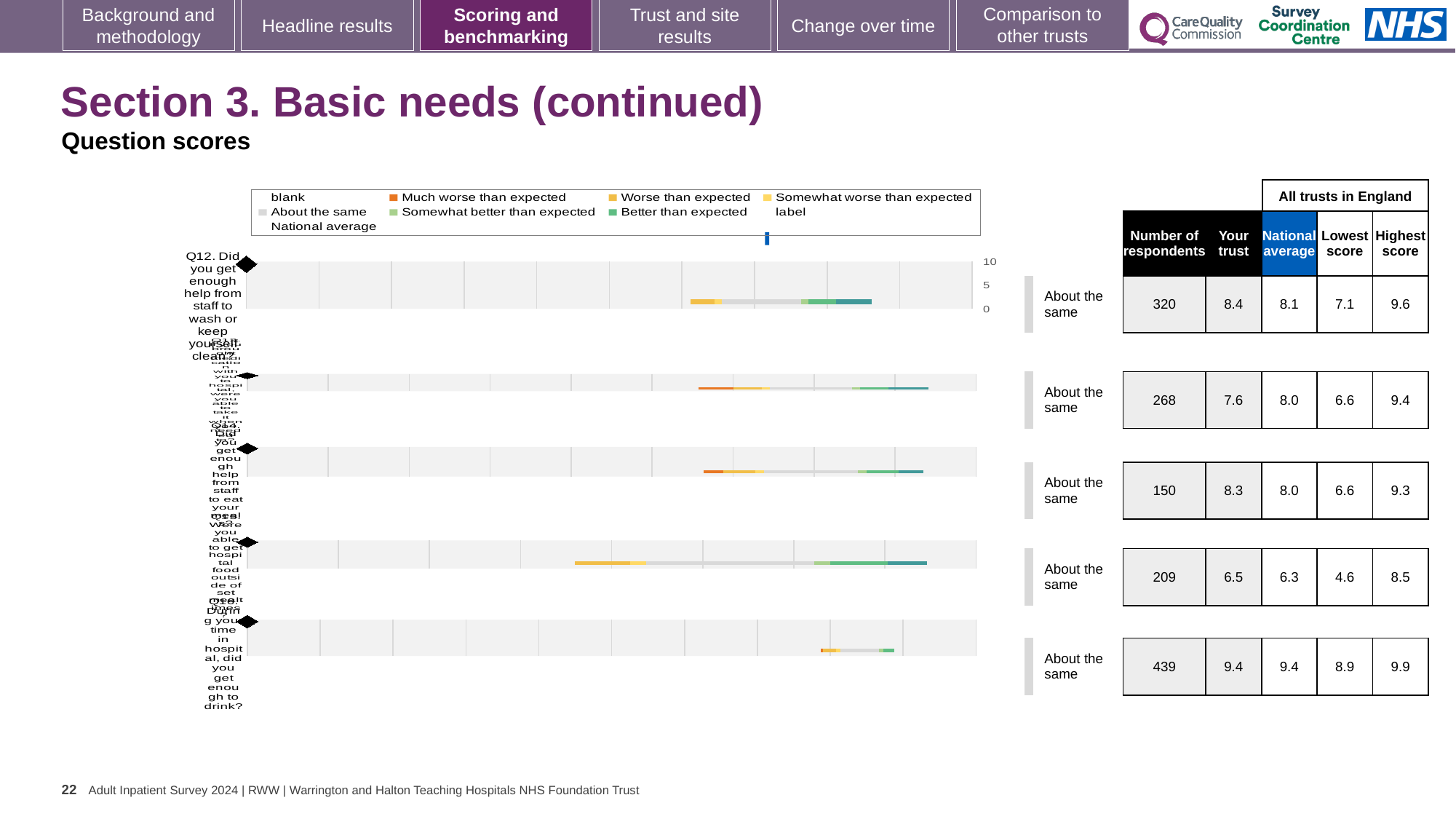
How many question rows (bars) are plotted in the chart? 5 What is the highest score among all trusts in England for Q12? 9.6 What colour does the legend use for 'About the same'? grey What kind of chart is shown on the slide? bar chart For Q12, is the trust score higher or lower than the national average? higher What is the 'Your trust' score for Q12 (help from staff to wash or keep yourself clean)? 8.4 What is the difference between the trust score and the national average for Q12? 0.3 What is the national average for Q12 (help from staff to wash or keep yourself clean)? 8.1 What colour does the legend use for 'Much worse than expected'? orange Which benchmark category is shown for every question row on the slide? About the same How many entries does the chart legend list? 9 How many respondents answered Q12 (help from staff to wash or keep yourself clean)? 320